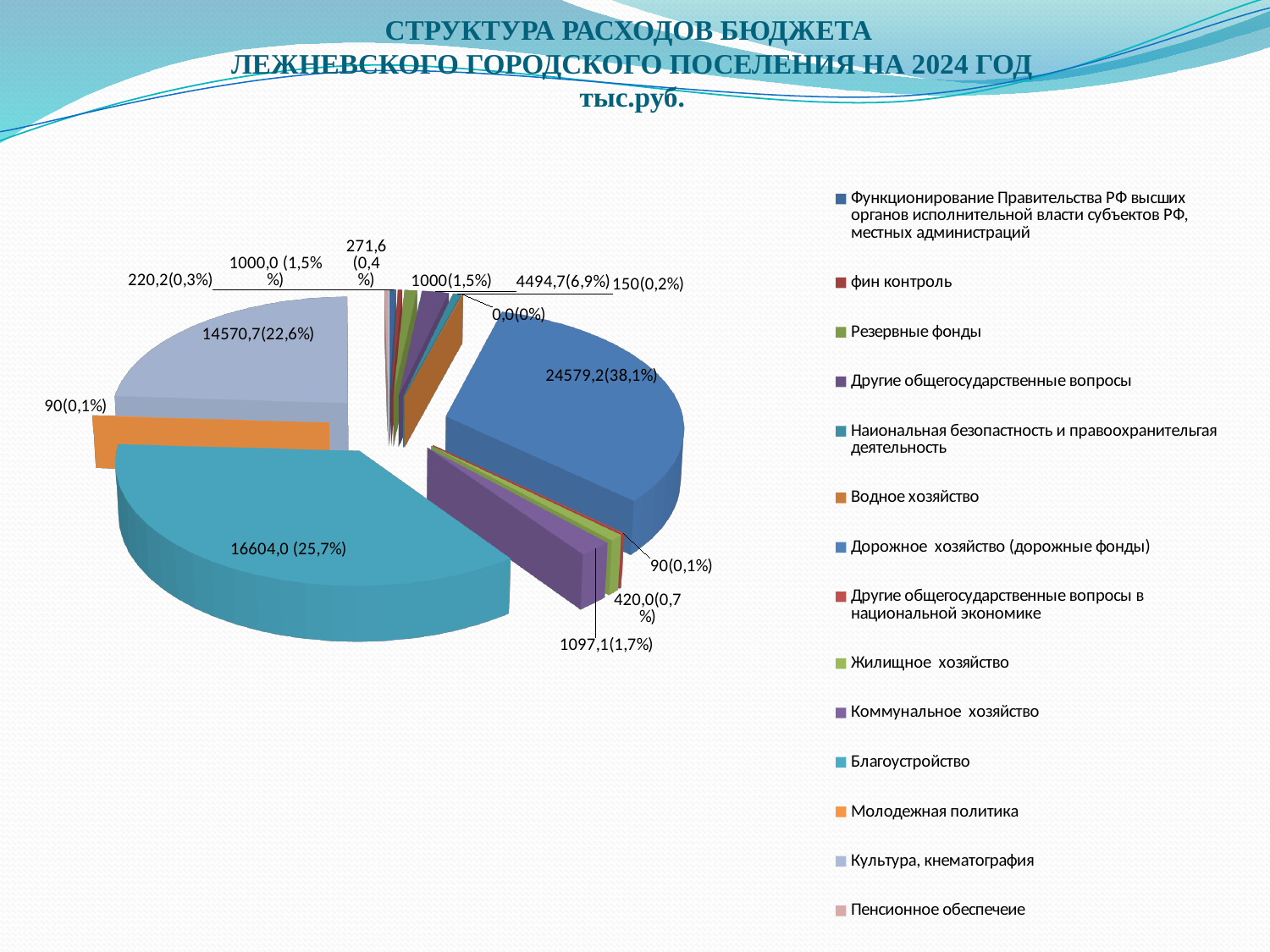
What value is labelled for Благоустройство? 16604,0 (25,7%) Which category has the largest slice of the pie chart? Дорожное хозяйство (дорожные фонды) What share of the pie does Культура, кнематография take? 22,6% What unit is stated under the chart title? тыс.руб. How many categories does the legend of the pie chart list? 14 What value is labelled for Молодежная политика? 90(0,1%) What value is labelled for Культура, кнематография? 14570,7(22,6%) What kind of chart is shown on the slide? pie chart Which is larger, the slice for Благоустройство or the slice for Культура, кнематография? Благоустройство What is the difference in thousand rubles between Благоустройство (16604,0) and Культура, кнематография (14570,7)? 2033,3 What value is labelled for Дорожное хозяйство (дорожные фонды)? 24579,2(38,1%) What value is labelled for Водное хозяйство? 4494,7(6,9%)